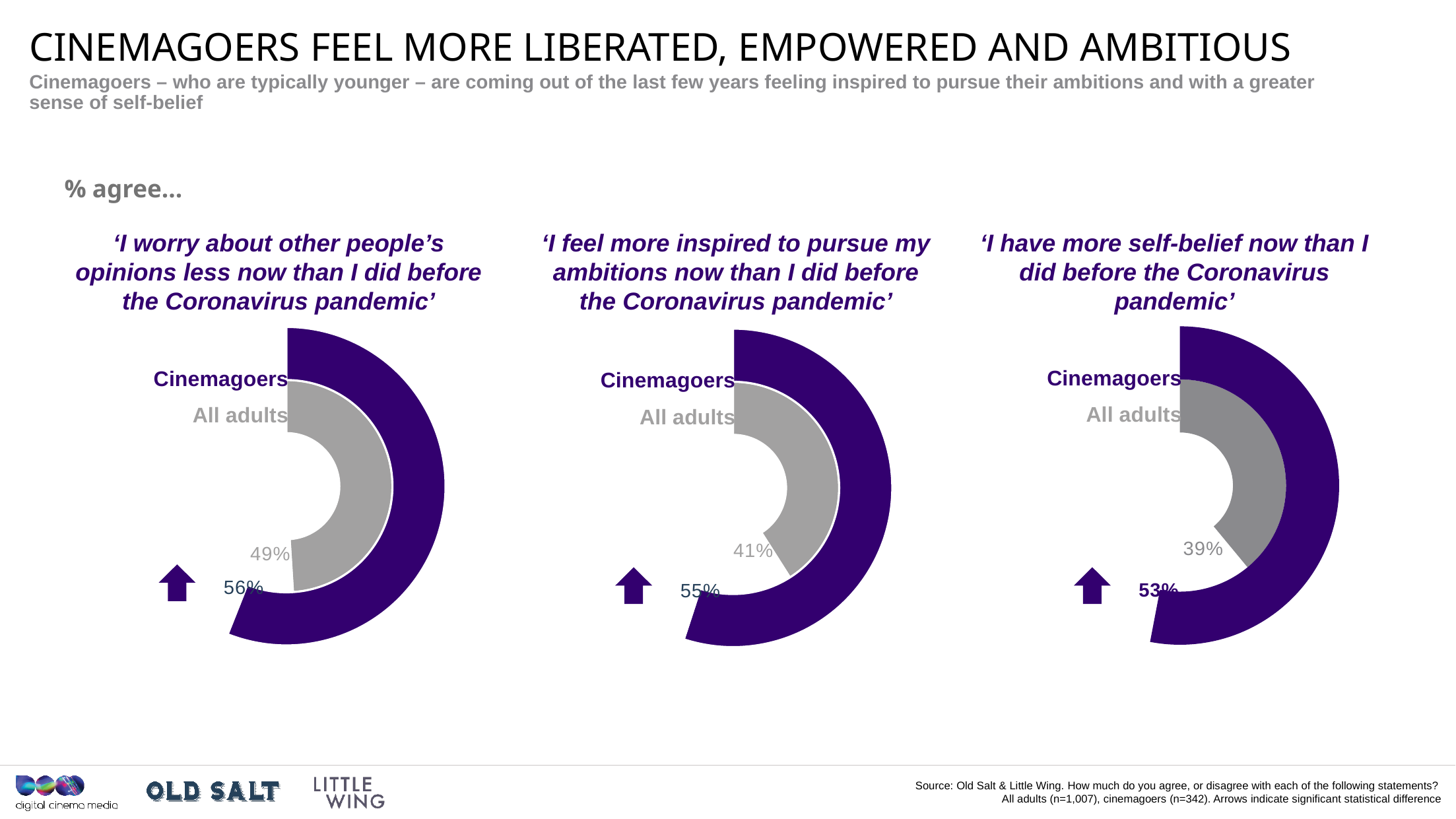
In the chart for 'I feel more inspired to pursue my ambitions now than I did before the Coronavirus pandemic', what is the difference in percentage points between cinemagoers and all adults? 14 In the chart for 'I worry about other people's opinions less now than I did before the Coronavirus pandemic', what percentage of all adults agree? 49% In the chart for 'I have more self-belief now than I did before the Coronavirus pandemic', what is the difference in percentage points between cinemagoers and all adults? 14 How many groups are compared in each chart on the slide? 2 In the chart for 'I feel more inspired to pursue my ambitions now than I did before the Coronavirus pandemic', what percentage of all adults agree? 41% In the chart for 'I worry about other people's opinions less now than I did before the Coronavirus pandemic', which group has the higher share agreeing, cinemagoers or all adults? Cinemagoers In the chart for 'I worry about other people's opinions less now than I did before the Coronavirus pandemic', what percentage of cinemagoers agree? 56% In the chart for 'I have more self-belief now than I did before the Coronavirus pandemic', what percentage of all adults agree? 39% In the chart for 'I have more self-belief now than I did before the Coronavirus pandemic', what percentage of cinemagoers agree? 53% Across the three charts, which statement has the lowest percentage of all adults agreeing? 'I have more self-belief now than I did before the Coronavirus pandemic' In the chart for 'I feel more inspired to pursue my ambitions now than I did before the Coronavirus pandemic', what percentage of cinemagoers agree? 55% What colour represents cinemagoers in the charts? Purple